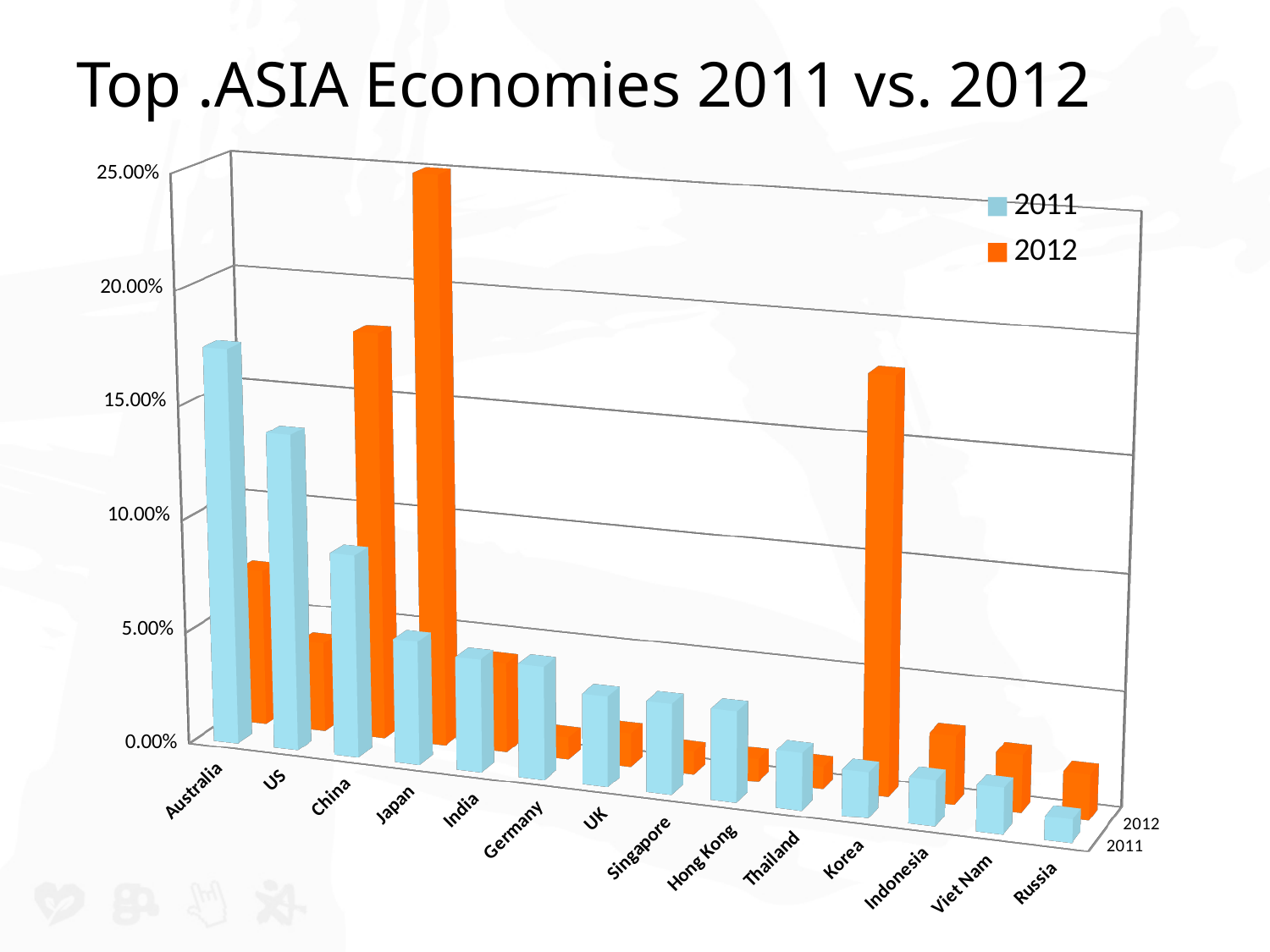
Is the 2012 value for Korea greater or less than 10.00%? greater For Australia, which year has the larger value, 2011 or 2012? 2011 Which economy has the highest value in the 2011 series? Australia Which economy has the lowest value in the 2011 series? Russia Is the 2012 value for Japan greater or less than 20.00%? greater For Japan, which year has the larger value, 2011 or 2012? 2012 How many series does the legend list? 2 Is the 2011 value for Australia greater or less than 15.00%? greater What is the title of the chart? Top .ASIA Economies 2011 vs. 2012 What kind of chart is shown on the slide? bar chart Which economy has the highest value in the 2012 series? Japan How many economies (categories) are shown on the x axis? 14